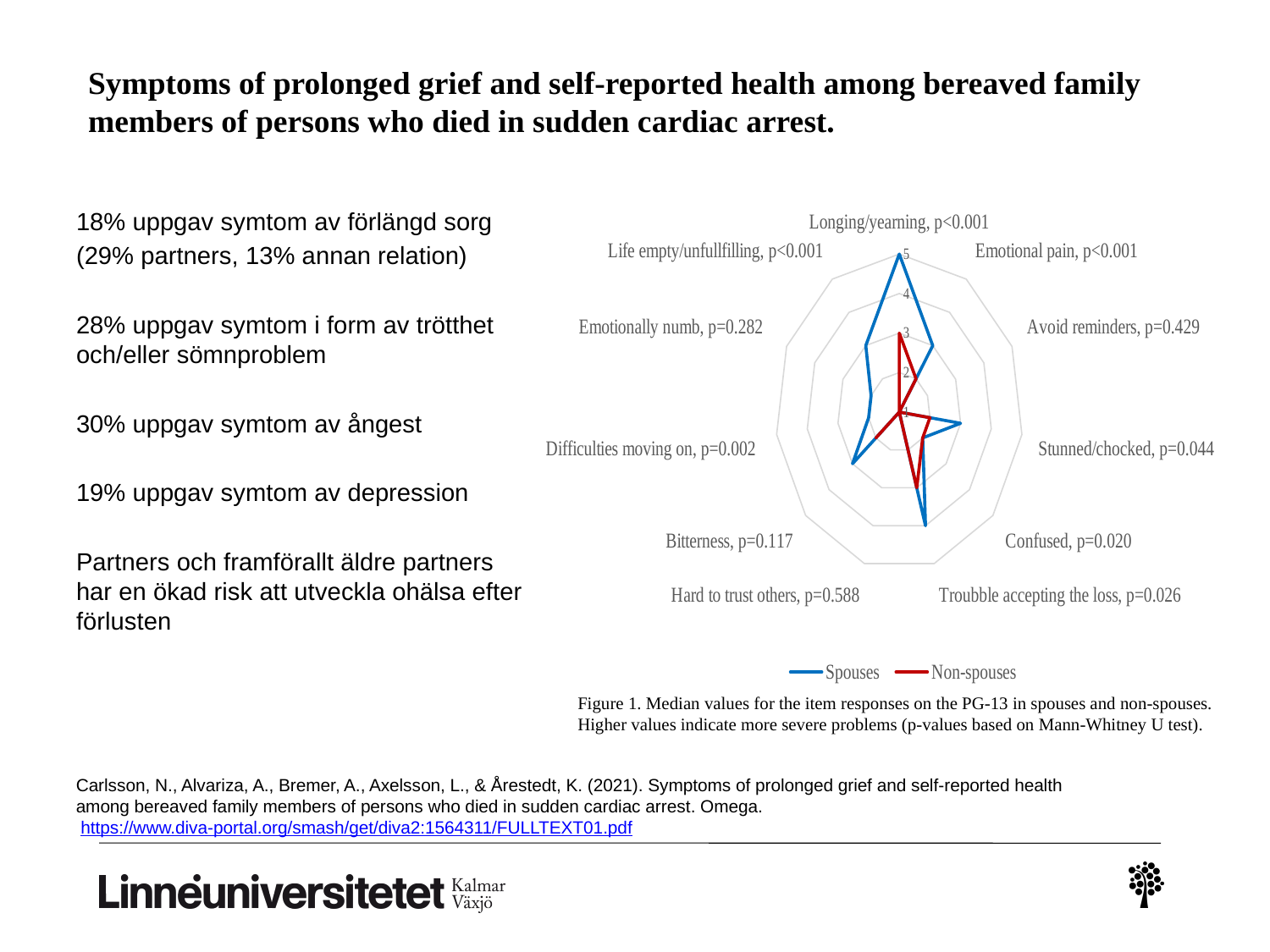
Which series has the larger value on Hard to trust others, Spouses or Non-spouses? Neither; they are equal How many series does the legend list? 2 What is the median value for Non-spouses on Longing/yearning? 3 What p-value is shown for the Emotionally numb axis? p=0.282 Is the value for Spouses on Longing/yearning greater or less than 4? greater Which series has the larger value on Longing/yearning, Spouses or Non-spouses? Spouses What kind of chart is shown on the slide? Radar chart Which series has the larger value on Difficulties moving on, Spouses or Non-spouses? Spouses What is the median value for Spouses on Longing/yearning? 5 Which two series are listed in the chart legend? Spouses and Non-spouses Is the value for Non-spouses on Longing/yearning greater or less than 4? less How many symptom categories (axes) does the radar chart have? 11